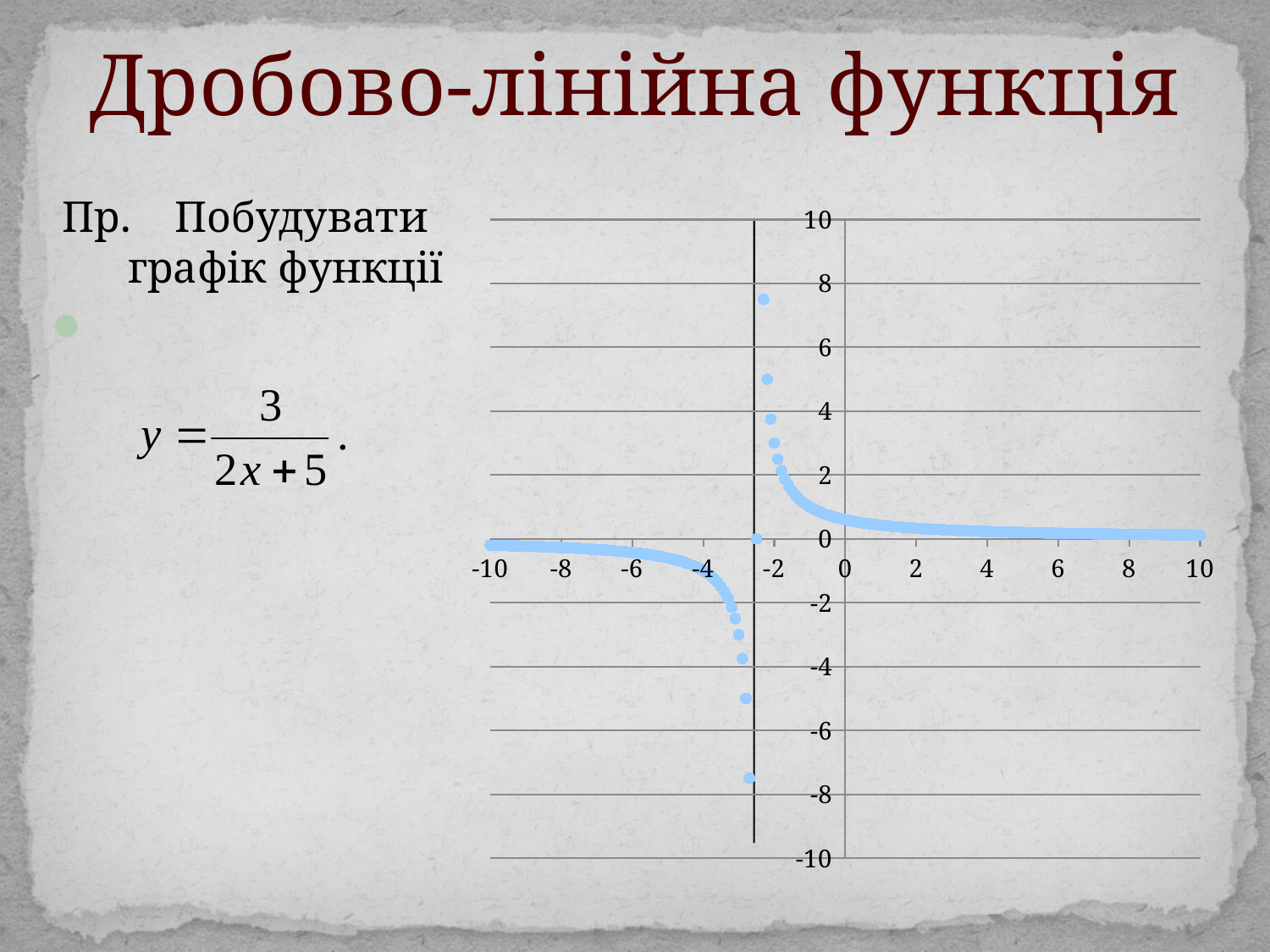
Is the plotted value at x = 0 greater or less than 2? less Is the plotted value at x = -4 greater or less than 0? less Which is larger, the plotted value at x = 0 or at x = 10? x = 0 For x values greater than -2, do the plotted values rise or fall as x increases? fall Is the plotted value at x = -4 greater or less than -2? greater What is the lowest value shown on the horizontal axis? -10 What kind of chart is shown on the slide? scatter chart Which is larger, the plotted value at x = -10 or at x = -4? x = -10 What is the highest value shown on the vertical axis? 10